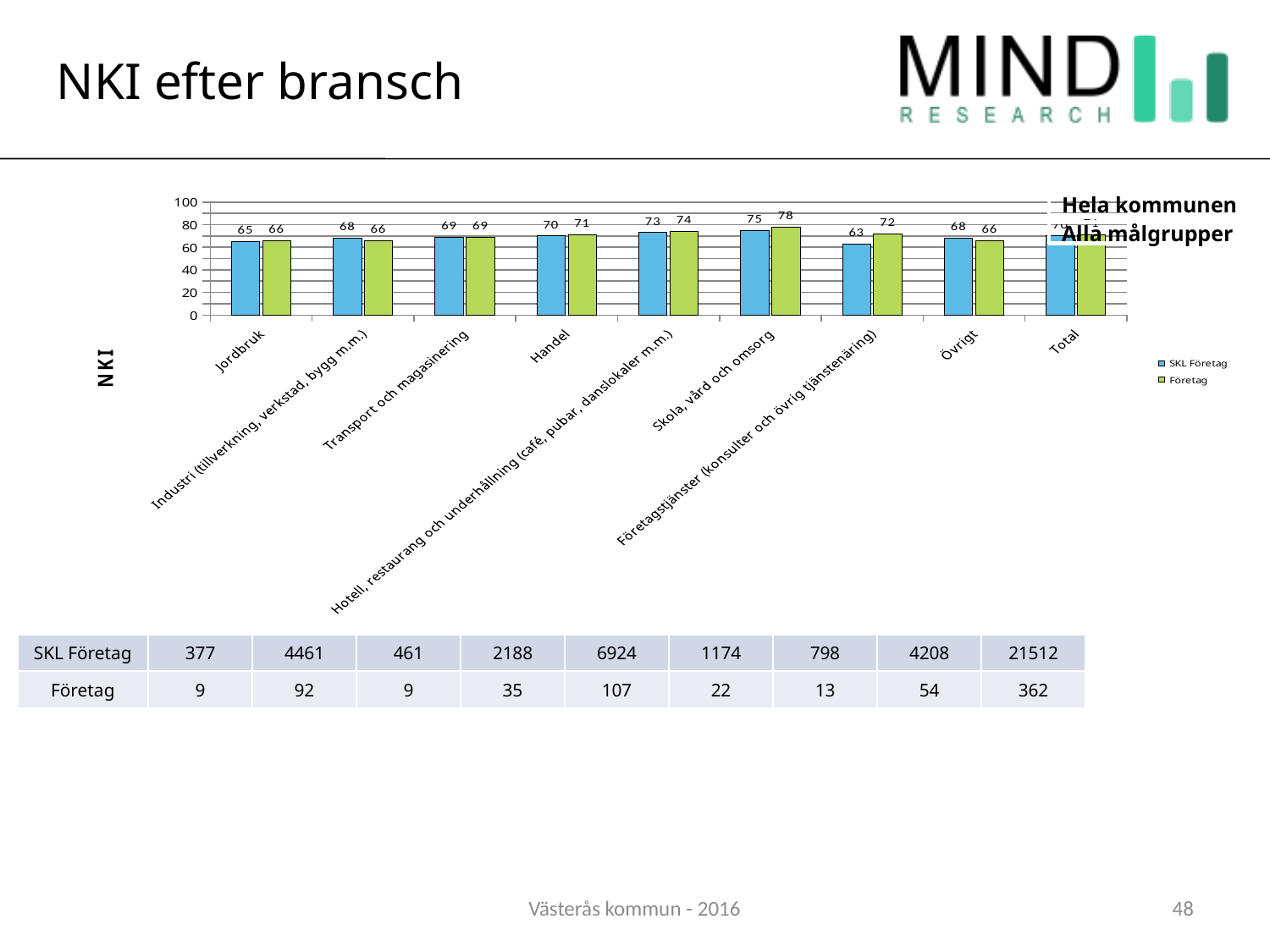
What is the Företag value for Handel? 71 What is the SKL Företag value for Jordbruk? 65 Which category has the lowest SKL Företag value? Företagstjänster (konsulter och övrig tjänstenäring) What kind of chart is shown on the slide? Bar chart What is the SKL Företag value for Företagstjänster (konsulter och övrig tjänstenäring)? 63 What is the label on the vertical axis of the chart? NKI What is the difference between the Företag and SKL Företag values for Företagstjänster (konsulter och övrig tjänstenäring)? 9 Is the Företag value for Skola, vård och omsorg greater or less than 60? greater Which category has the highest Företag value? Skola, vård och omsorg For Industri (tillverkning, verkstad, bygg m.m.), which is larger: the SKL Företag value or the Företag value? SKL Företag How many series does the legend list? 2 What is the Företag value for Skola, vård och omsorg? 78